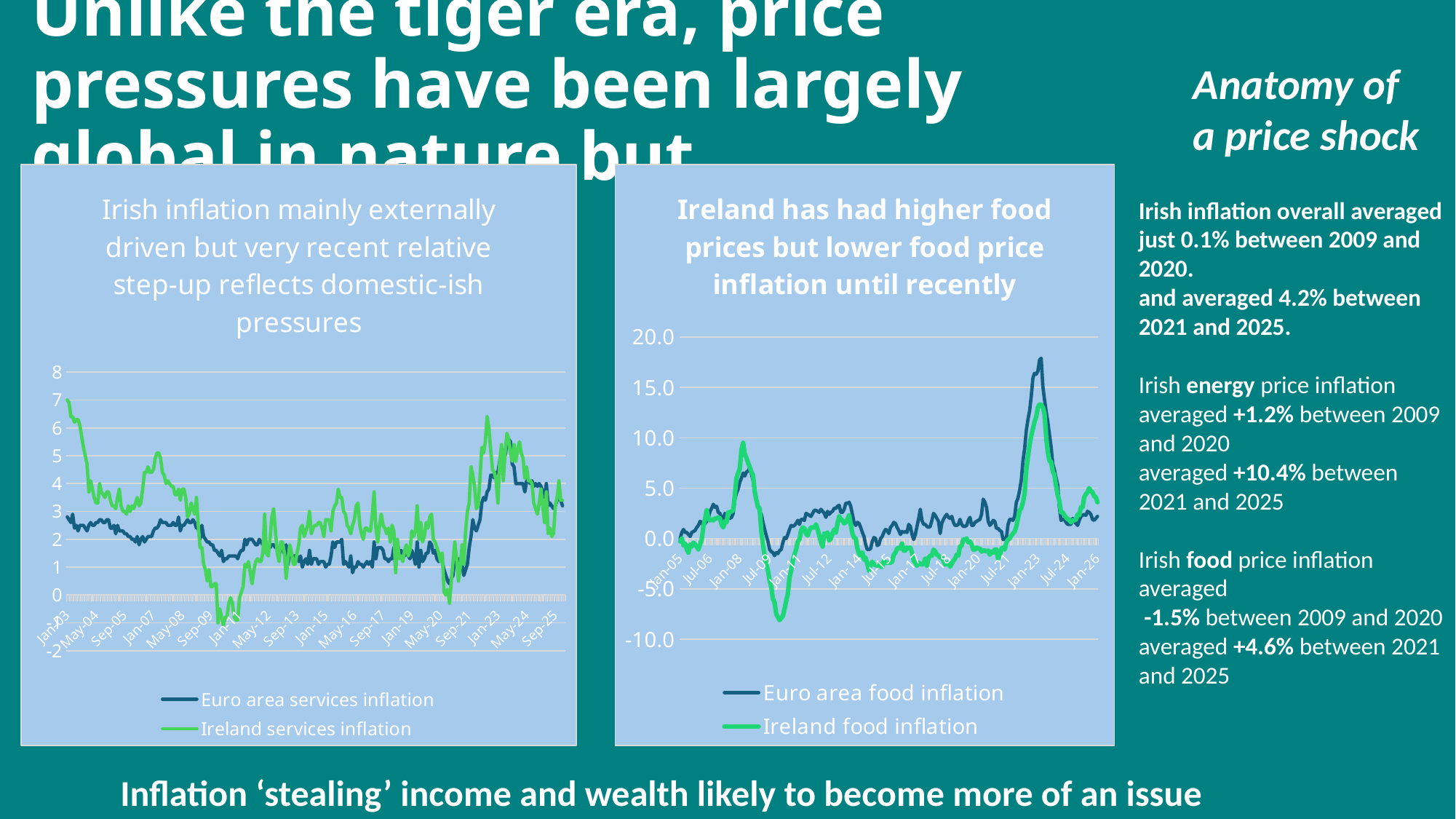
In the right chart, is the lowest value of Ireland food inflation (around 2010-2011) greater or less than -5.0? less In the left chart, which series is shown in dark blue? Euro area services inflation In the right chart, is the peak value of Ireland food inflation around Jan-23 greater or less than 15.0? less In the right chart, which series reaches the higher peak around Jan-23, Euro area food inflation or Ireland food inflation? Euro area food inflation In the left chart, which series is higher at Jan-03, Euro area services inflation or Ireland services inflation? Ireland services inflation What kind of chart is the right chart titled 'Ireland has had higher food prices but lower food price inflation until recently'? Line chart In the right chart, is the peak value of Euro area food inflation around Jan-23 greater or less than 15.0? greater In the right chart, which series is shown in green? Ireland food inflation What kind of chart is the left chart titled 'Irish inflation mainly externally driven but very recent relative step-up reflects domestic-ish pressures'? Line chart How many series does the legend of the left chart list? 2 How many series does the legend of the right chart list? 2